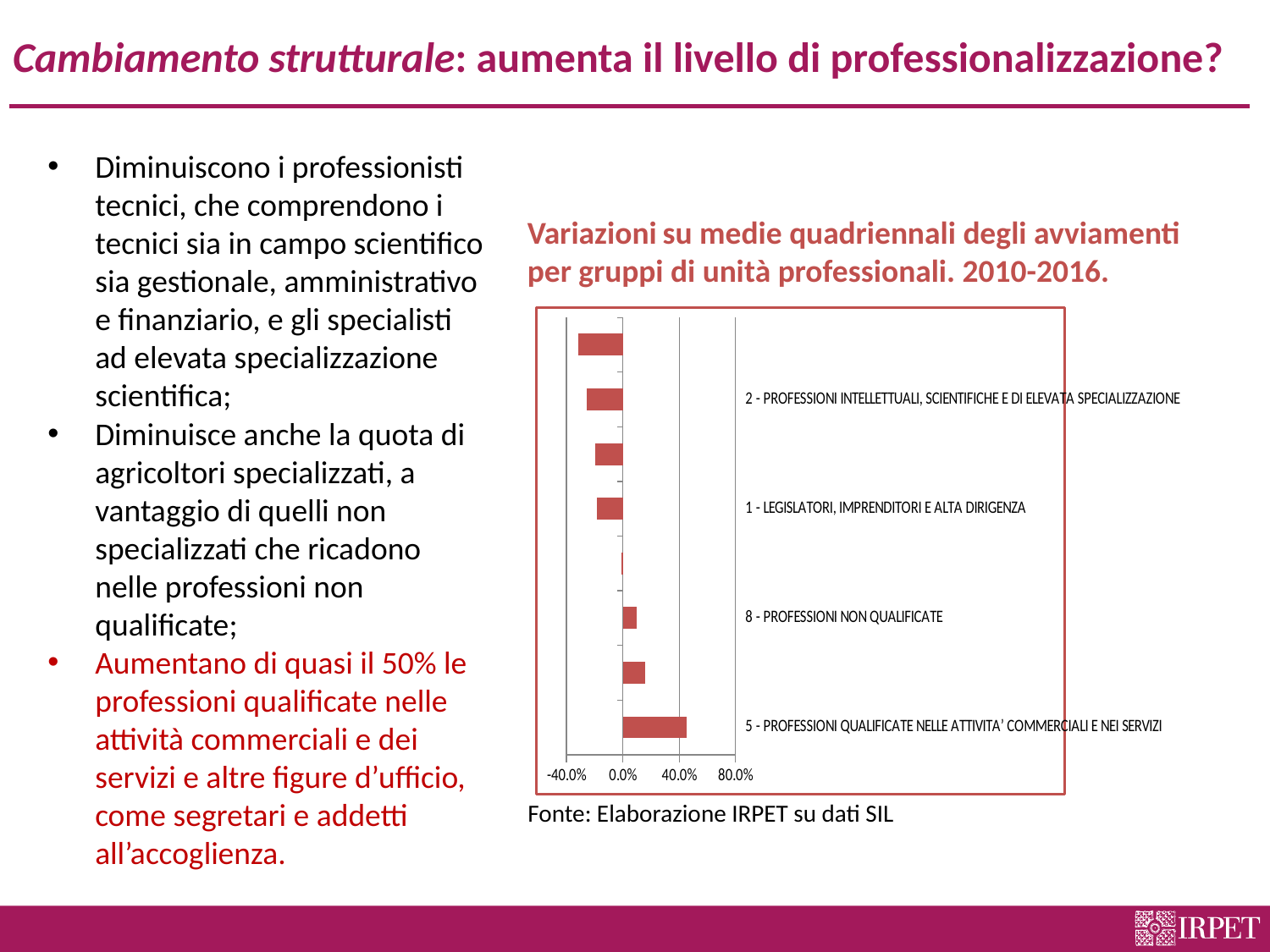
Is the value for '8 - PROFESSIONI NON QUALIFICATE' greater or less than 0.0%? greater Is the value for '1 - LEGISLATORI, IMPRENDITORI E ALTA DIRIGENZA' greater or less than 0.0%? less Is the value for '2 - PROFESSIONI INTELLETTUALI, SCIENTIFICHE E DI ELEVATA SPECIALIZZAZIONE' greater or less than 0.0%? less What is the title of the chart? Variazioni su medie quadriennali degli avviamenti per gruppi di unità professionali. 2010-2016. How many bars are plotted in the chart? 8 Which is larger, the value for '8 - PROFESSIONI NON QUALIFICATE' or for '2 - PROFESSIONI INTELLETTUALI, SCIENTIFICHE E DI ELEVATA SPECIALIZZAZIONE'? 8 - PROFESSIONI NON QUALIFICATE What source is cited below the chart? Fonte: Elaborazione IRPET su dati SIL What kind of chart is shown on the slide? bar chart Which is larger, the value for '5 - PROFESSIONI QUALIFICATE NELLE ATTIVITA' COMMERCIALI E NEI SERVIZI' or for '8 - PROFESSIONI NON QUALIFICATE'? 5 - PROFESSIONI QUALIFICATE NELLE ATTIVITA' COMMERCIALI E NEI SERVIZI Which category has the highest value in the chart? 5 - PROFESSIONI QUALIFICATE NELLE ATTIVITA' COMMERCIALI E NEI SERVIZI